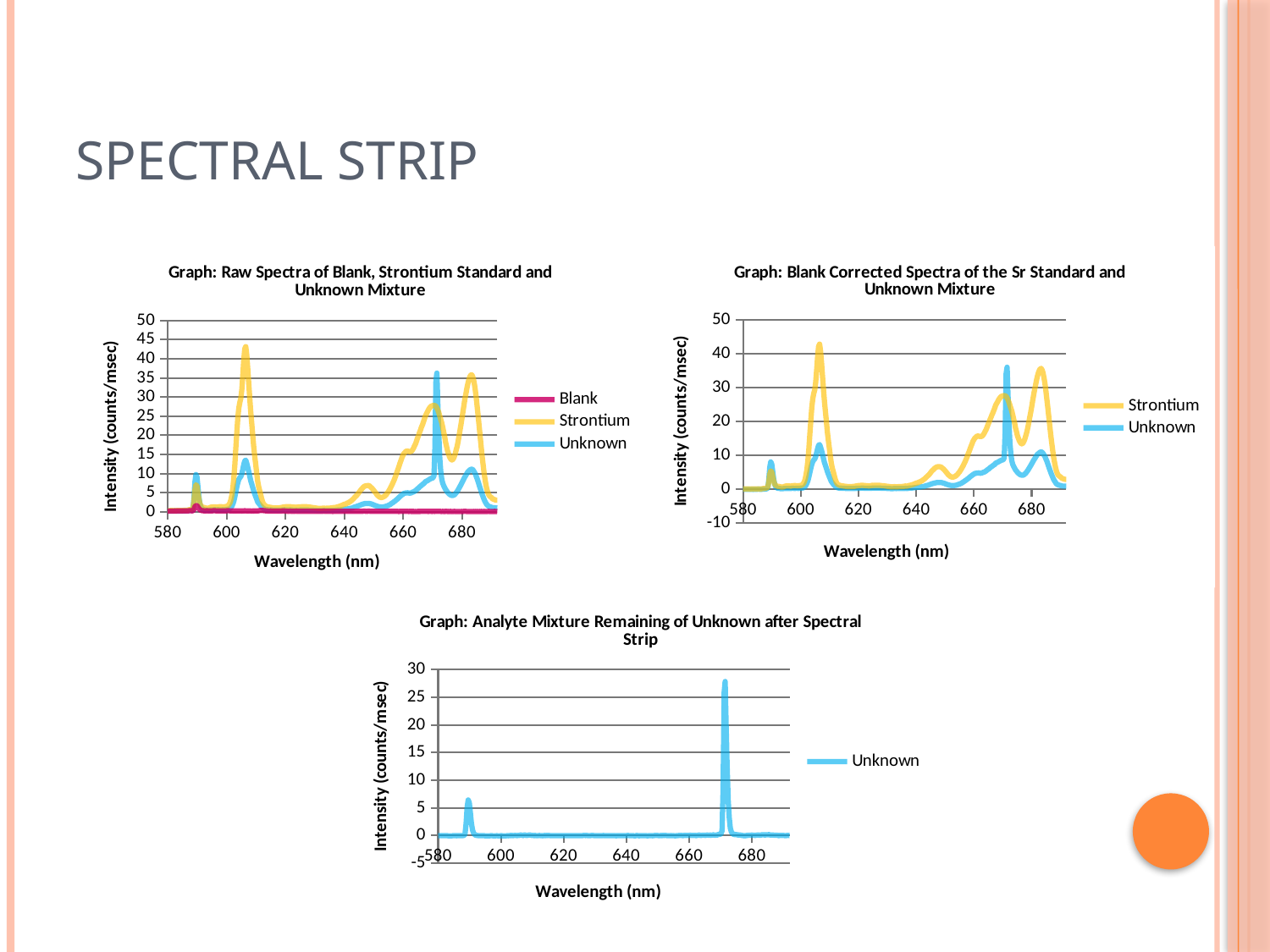
How many series does the legend list in the chart titled "Graph: Analyte Mixture Remaining of Unknown after Spectral Strip"? 1 In the chart titled "Graph: Analyte Mixture Remaining of Unknown after Spectral Strip", is the tallest peak greater or less than 25? greater In the chart titled "Graph: Analyte Mixture Remaining of Unknown after Spectral Strip", is the small peak near 590 nm greater or less than 10? less In the chart titled "Graph: Raw Spectra of Blank, Strontium Standard and Unknown Mixture", is the highest peak of the Strontium series greater or less than 40? greater What is the x-axis label of the chart titled "Graph: Analyte Mixture Remaining of Unknown after Spectral Strip"? Wavelength (nm) In the chart titled "Graph: Raw Spectra of Blank, Strontium Standard and Unknown Mixture", which series has the higher peak near 607 nm, Strontium or Unknown? Strontium How many series does the legend list in the chart titled "Graph: Raw Spectra of Blank, Strontium Standard and Unknown Mixture"? 3 Which series names appear in the legend of the chart titled "Graph: Blank Corrected Spectra of the Sr Standard and Unknown Mixture"? Strontium, Unknown What kind of chart is the chart titled "Graph: Raw Spectra of Blank, Strontium Standard and Unknown Mixture"? Line chart How many series does the legend list in the chart titled "Graph: Blank Corrected Spectra of the Sr Standard and Unknown Mixture"? 2